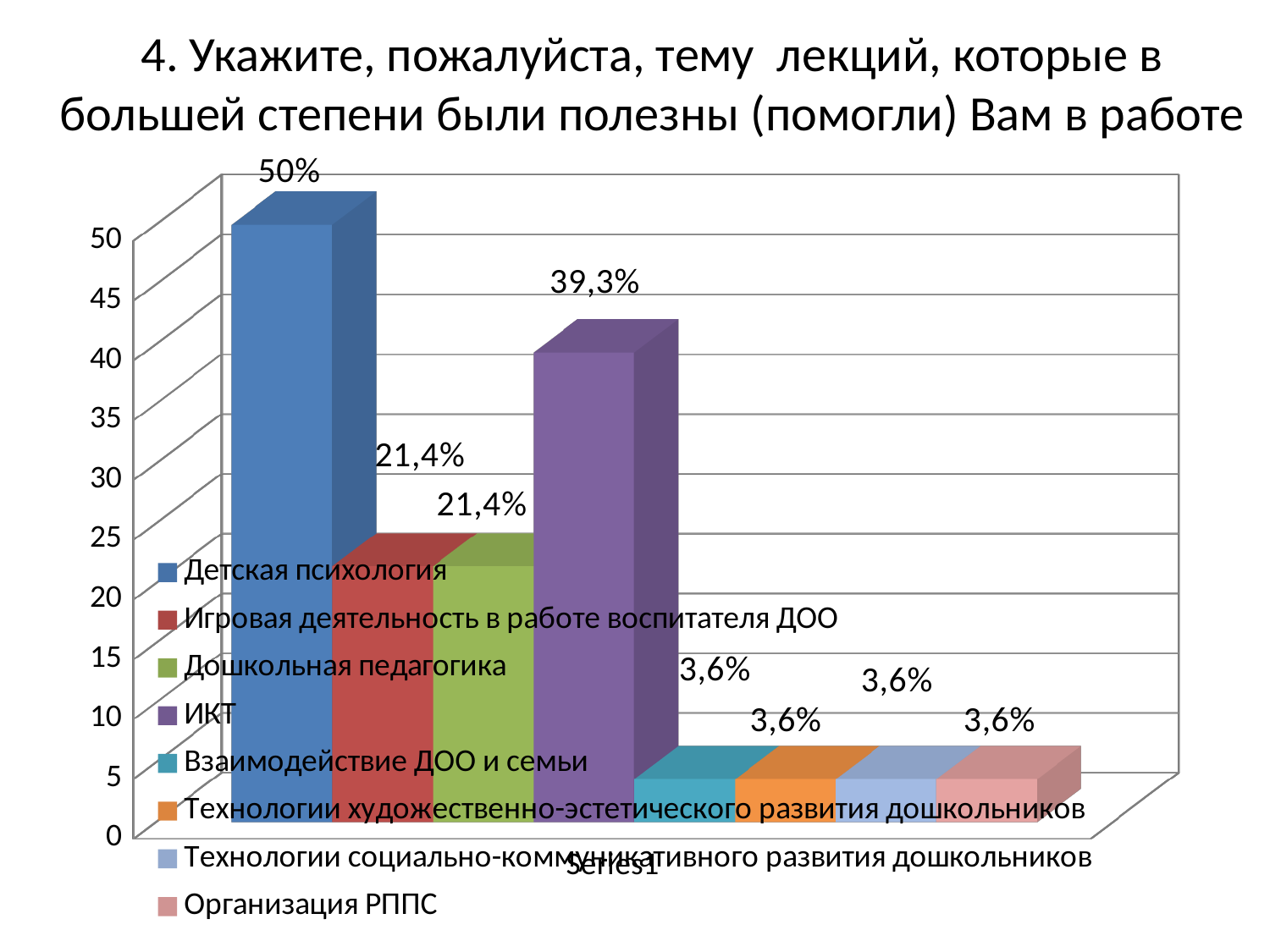
Which is larger, the value for ИКТ or the value for Дошкольная педагогика? ИКТ What value is shown for Детская психология? 50% How many series does the legend list? 8 What value is shown for Игровая деятельность в работе воспитателя ДОО? 21,4% What kind of chart is shown on the slide? bar chart What colour is the bar for ИКТ? purple What is the difference between the values for Детская психология and ИКТ? 10,7% What value is shown for ИКТ? 39,3% What is the difference between the values for ИКТ and Дошкольная педагогика? 17,9% Which legend entry has the highest value? Детская психология What value is shown for Организация РППС? 3,6% Is the value for Взаимодействие ДОО и семьи greater or less than 5? less